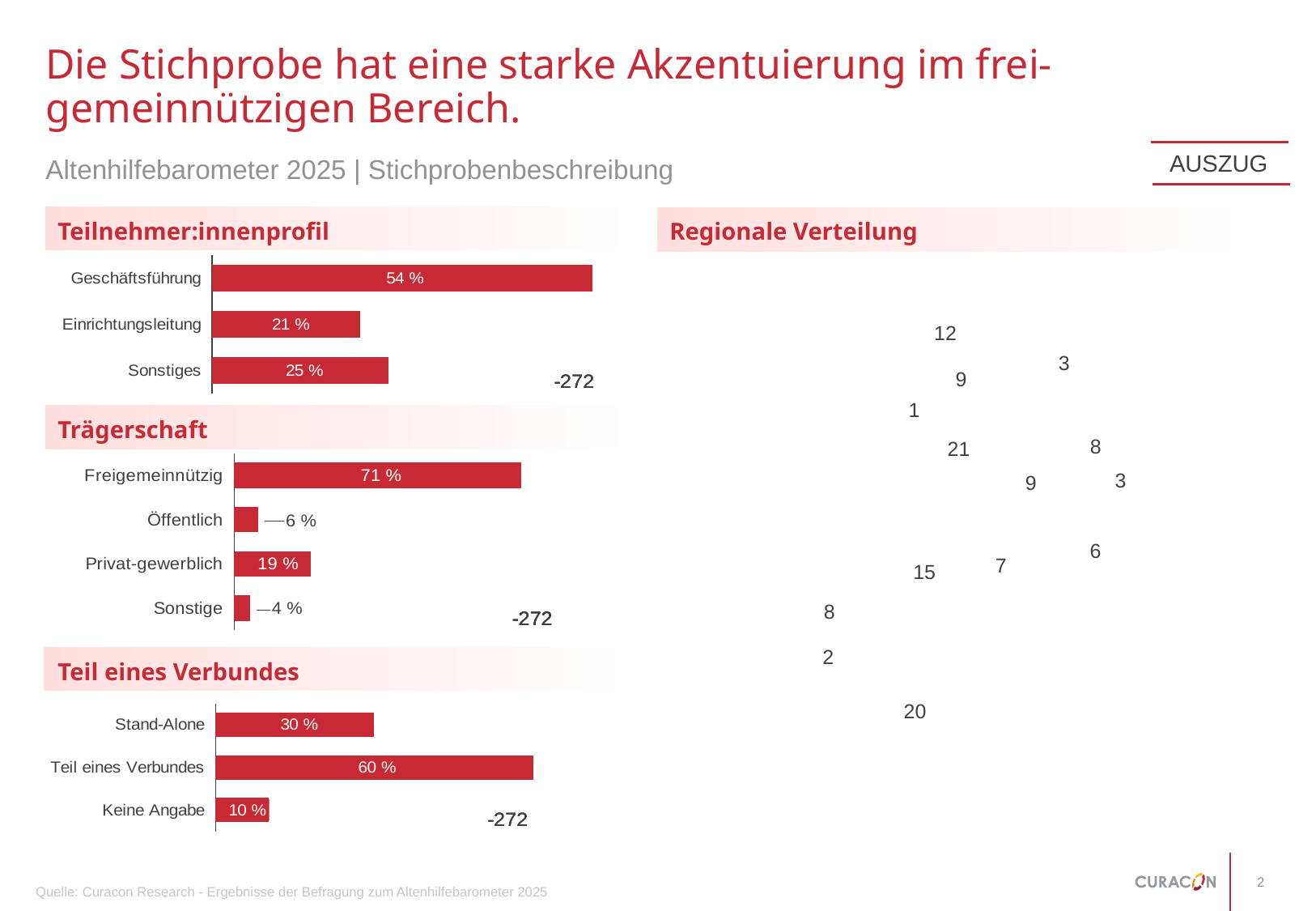
In the "Trägerschaft" chart, which is larger, Öffentlich or Privat-gewerblich? Privat-gewerblich In the "Teilnehmer:innenprofil" chart, how many categories are shown? 3 In the "Teilnehmer:innenprofil" chart, what is the value for Geschäftsführung? 54 % In the "Trägerschaft" chart, how many categories are shown? 4 In the "Teilnehmer:innenprofil" chart, which category has the lowest value? Einrichtungsleitung In the "Teilnehmer:innenprofil" chart, what is the difference between Geschäftsführung and Sonstiges? 29 % What type of chart is the "Teil eines Verbundes" chart? Bar chart In the "Trägerschaft" chart, what is the value for Privat-gewerblich? 19 % In the "Teil eines Verbundes" chart, what is the value for Stand-Alone? 30 % In the "Trägerschaft" chart, which category has the highest value? Freigemeinnützig In the "Teil eines Verbundes" chart, what is the difference between Teil eines Verbundes and Keine Angabe? 50 % In the "Trägerschaft" chart, which category has the lowest value? Sonstige